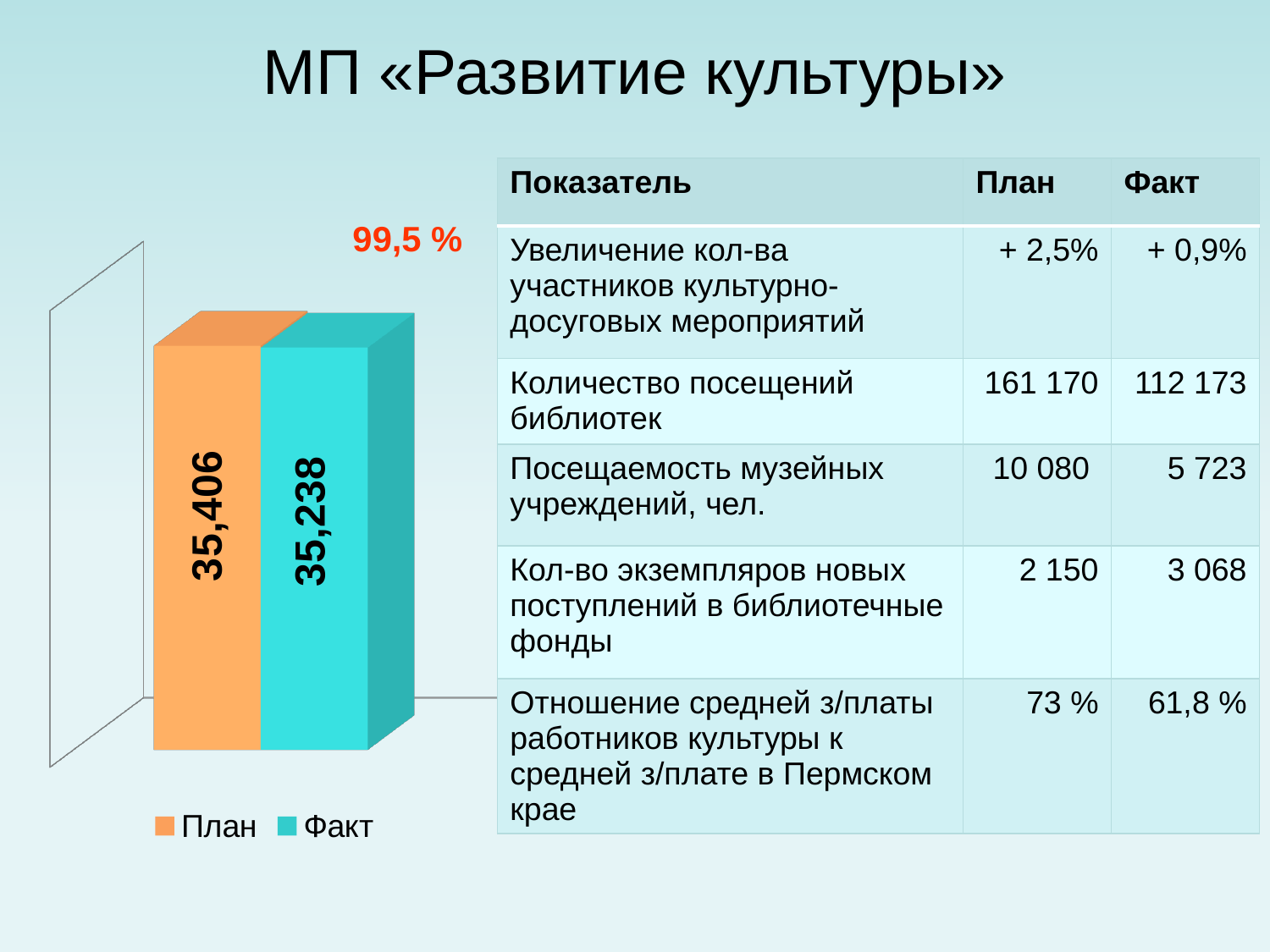
What is the value of the Факт bar in the chart? 35,238 How many series does the chart legend list? 2 Is the План value larger or smaller than the Факт value in the chart? larger What is the difference between the План and Факт values in the chart? 0,168 What colour is the Факт bar in the chart? teal What is the value of the План bar in the chart? 35,406 Which bar in the chart has the lowest value? Факт Which bar in the chart is higher, План or Факт? План How many bars are plotted in the chart? 2 What percentage is printed above the bars in the chart? 99,5 % What type of chart is shown on the slide? bar chart